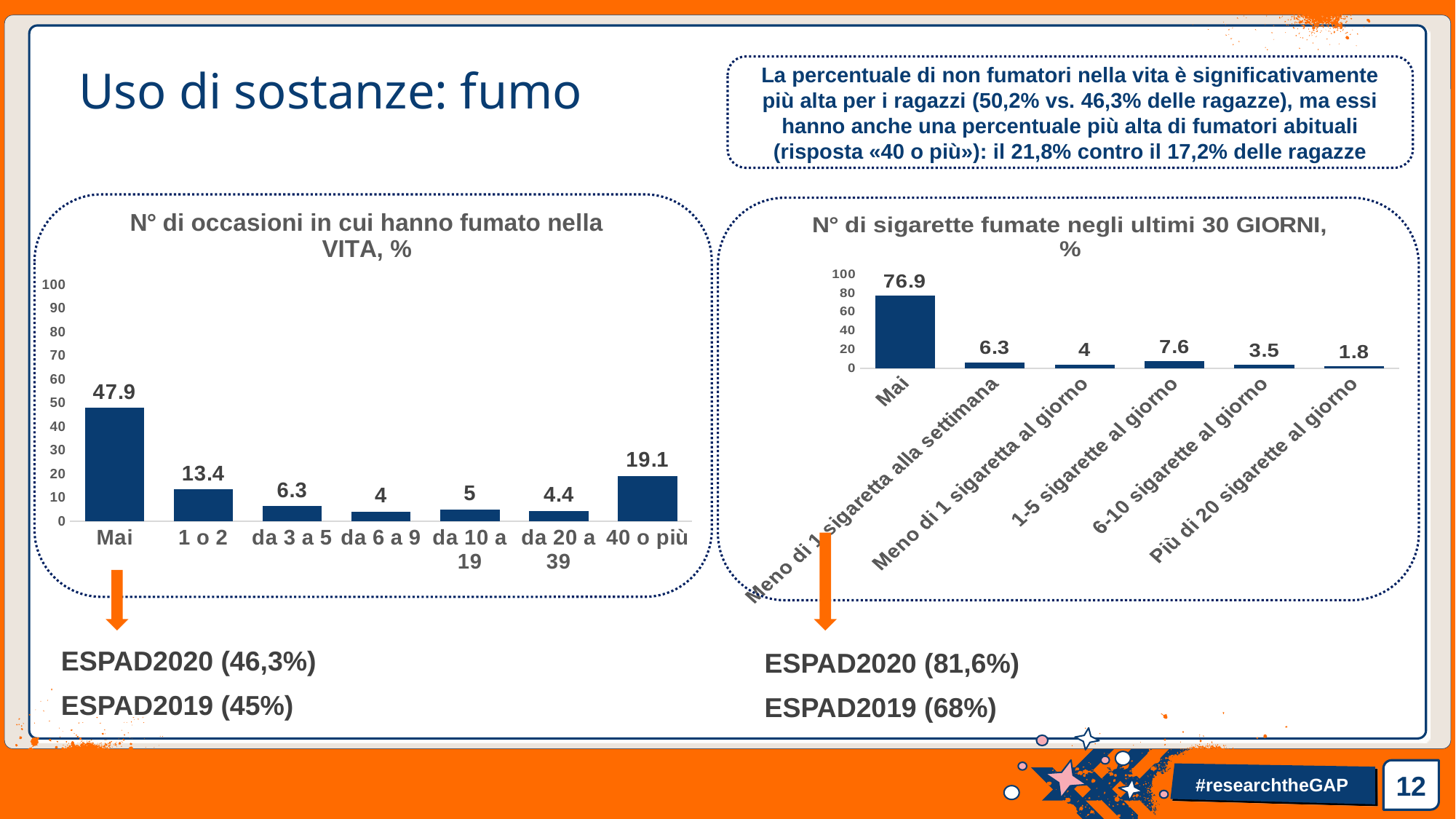
In the chart 'N° di occasioni in cui hanno fumato nella VITA, %', which is larger: 'da 10 a 19' or 'da 20 a 39'? da 10 a 19 In the chart 'N° di sigarette fumate negli ultimi 30 GIORNI, %', which category has the lowest value? Più di 20 sigarette al giorno In the chart 'N° di sigarette fumate negli ultimi 30 GIORNI, %', what is the value for 'Mai'? 76.9 What type of chart is 'N° di sigarette fumate negli ultimi 30 GIORNI, %'? bar chart In the chart 'N° di sigarette fumate negli ultimi 30 GIORNI, %', what is the value for '1-5 sigarette al giorno'? 7.6 In the chart 'N° di occasioni in cui hanno fumato nella VITA, %', what is the value for '40 o più'? 19.1 In the chart 'N° di sigarette fumate negli ultimi 30 GIORNI, %', what is the difference between 'Meno di 1 sigaretta alla settimana' and '6-10 sigarette al giorno'? 2.8 In the chart 'N° di sigarette fumate negli ultimi 30 GIORNI, %', how many categories are shown? 6 In the chart 'N° di occasioni in cui hanno fumato nella VITA, %', which category has the lowest value? da 6 a 9 In the chart 'N° di occasioni in cui hanno fumato nella VITA, %', what is the difference between 'Mai' and '1 o 2'? 34.5 In the chart 'N° di occasioni in cui hanno fumato nella VITA, %', what is the value for 'Mai'? 47.9 In the chart 'N° di occasioni in cui hanno fumato nella VITA, %', how many categories are shown on the x axis? 7